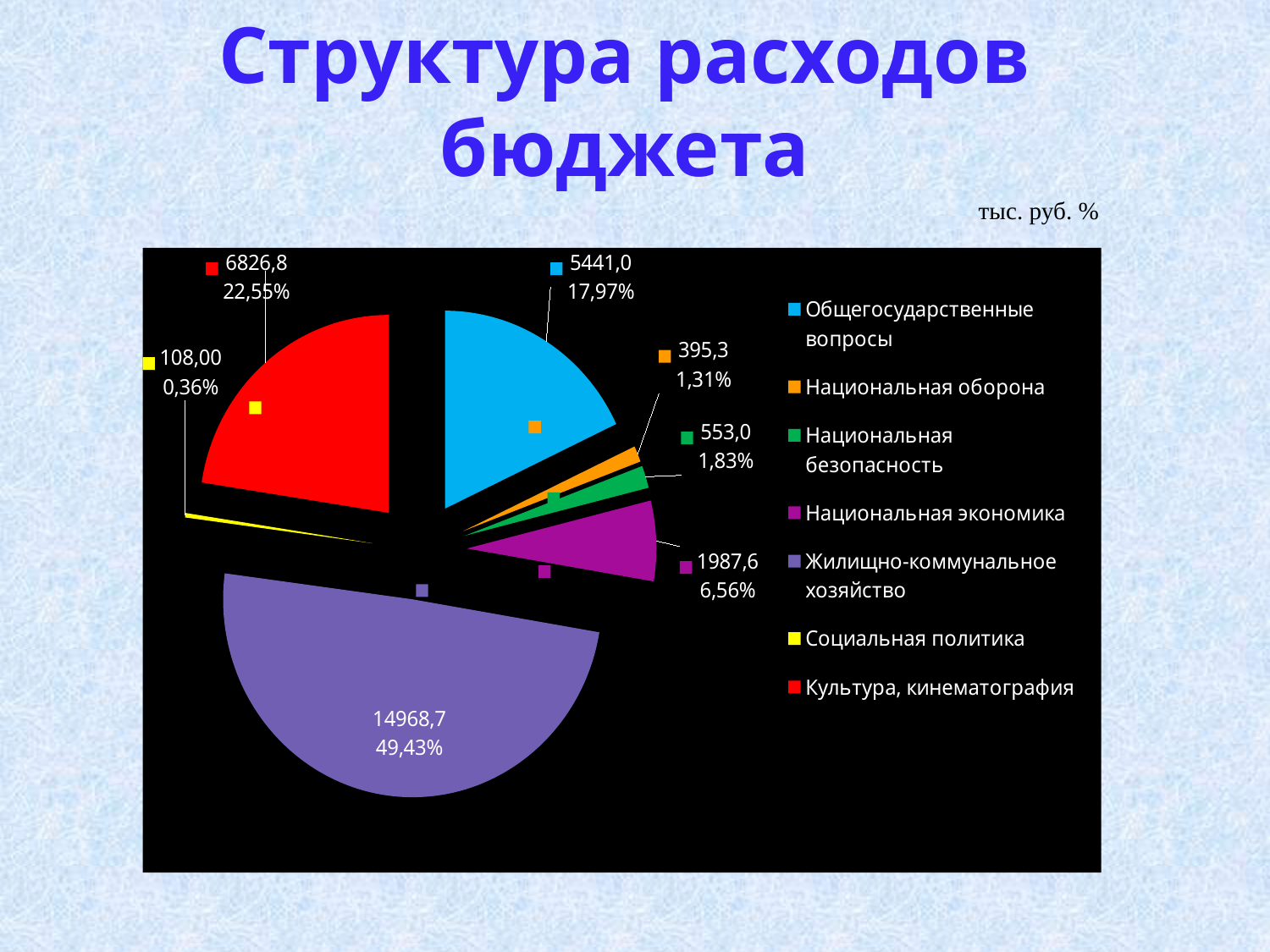
Which is larger, Национальная безопасность or Национальная оборона? Национальная безопасность Which category has the largest slice of the pie? Жилищно-коммунальное хозяйство Which category has the smallest slice of the pie? Социальная политика What kind of chart is shown on the slide? pie chart What is the difference in thousand rubles between Культура, кинематография and Общегосударственные вопросы? 1385,8 What percentage share does Культура, кинематография have? 22,55% What is the value in thousand rubles for Социальная политика? 108,00 What percentage share does Национальная оборона have? 1,31% What is the value in thousand rubles for Жилищно-коммунальное хозяйство? 14968,7 How many categories does the pie chart show? 7 What colour is the slice for Национальная экономика? purple What is the value in thousand rubles for Общегосударственные вопросы? 5441,0